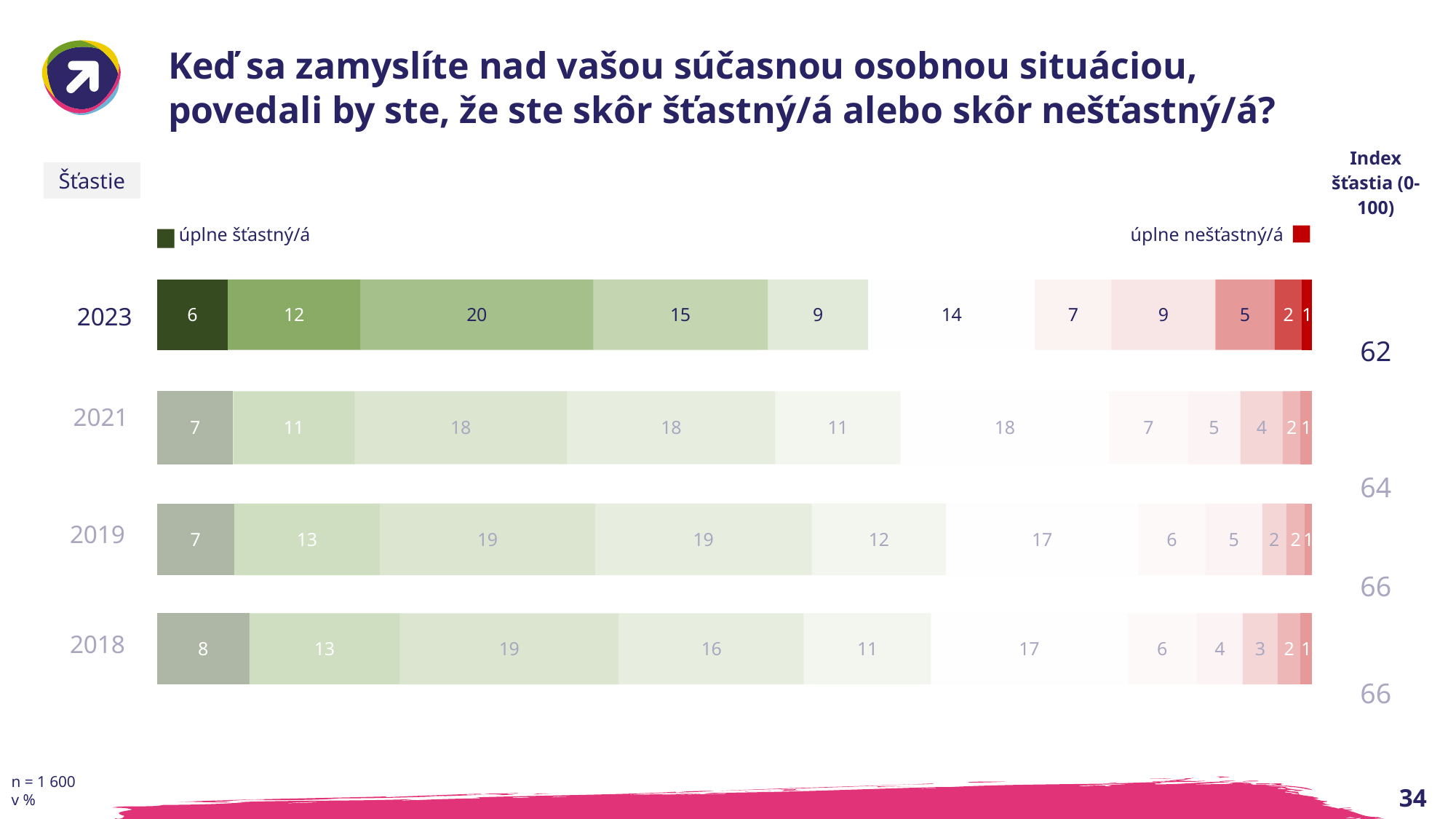
What is the largest segment value in the 2023 bar? 20 What is the value of the first segment ('úplne šťastný/á') for 2018? 8 What is the 'Index šťastia' value for 2021? 64 What is the difference between the first segment values for 2018 and 2023? 2 What kind of chart is shown on the slide? stacked bar chart Which year has the highest value in the first segment ('úplne šťastný/á')? 2018 What is the value of the 'úplne šťastný/á' segment (first segment) for 2023? 6 How many years (bars) are shown in the chart? 4 What is the 'Index šťastia' value for 2023? 62 What label does the legend show next to the dark green square on the left? úplne šťastný/á Which year has the lowest value in the first segment ('úplne šťastný/á')? 2023 Which year has the larger 'Index šťastia', 2023 or 2019? 2019